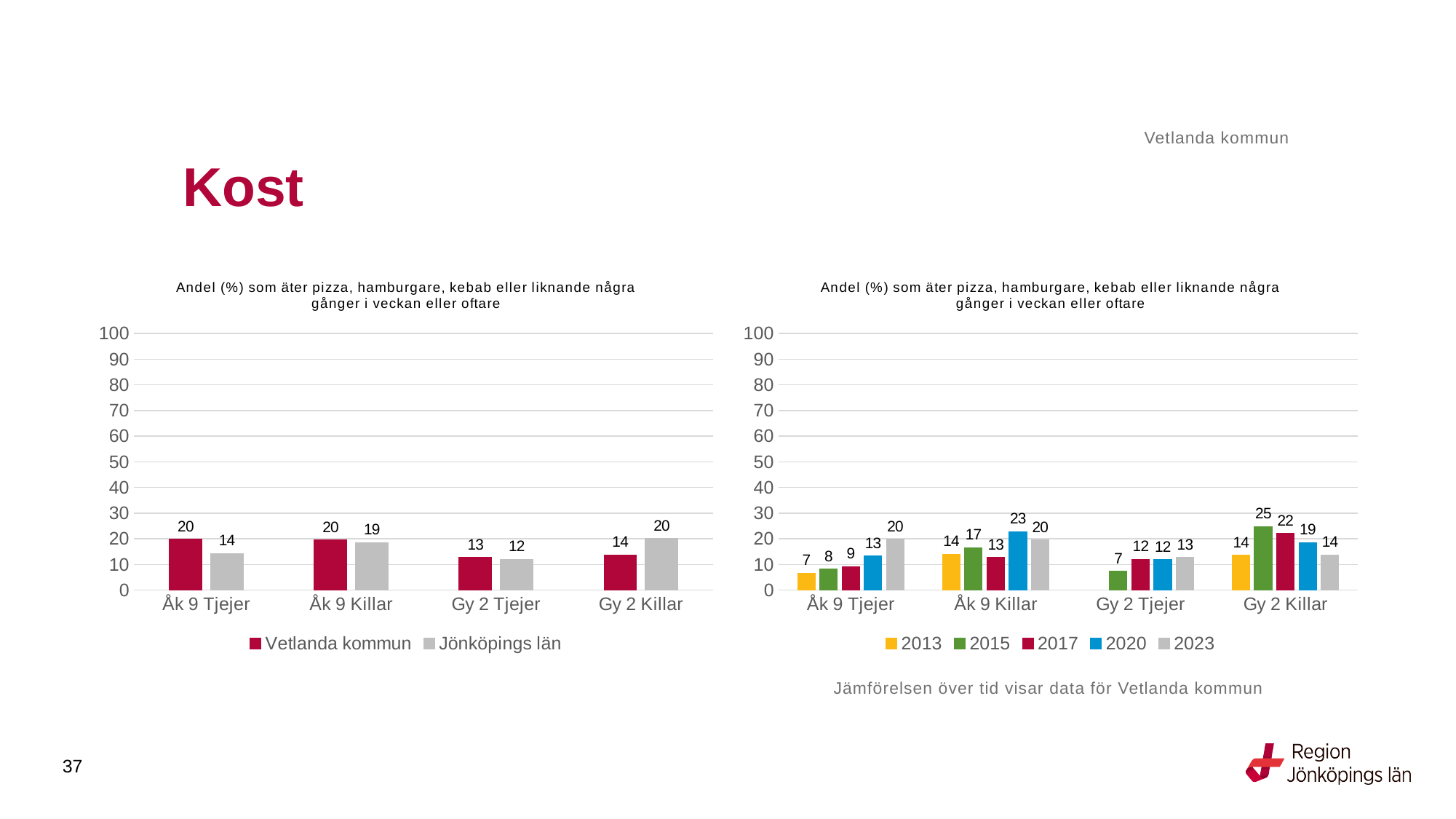
In the right chart, which year has the highest value for Åk 9 Tjejer? 2023 In the left chart, what is the value for Jönköpings län for Gy 2 Killar? 20 In the left chart, which is larger for Gy 2 Killar: Vetlanda kommun or Jönköpings län? Jönköpings län In the left chart, what is the difference between Vetlanda kommun and Jönköpings län for Åk 9 Tjejer? 6 In the right chart, how many series does the legend list? 5 What kind of chart is the left chart? bar chart In the right chart, what is the value for 2015 for Gy 2 Killar? 25 In the left chart, how many series does the legend list? 2 In the right chart, do the values for Åk 9 Tjejer rise or fall from 2013 to 2023? rise In the right chart, which year has the lowest value for Gy 2 Killar? 2013 and 2023 In the right chart, what is the value for 2020 for Åk 9 Killar? 23 In the left chart, what is the value for Vetlanda kommun for Gy 2 Tjejer? 13